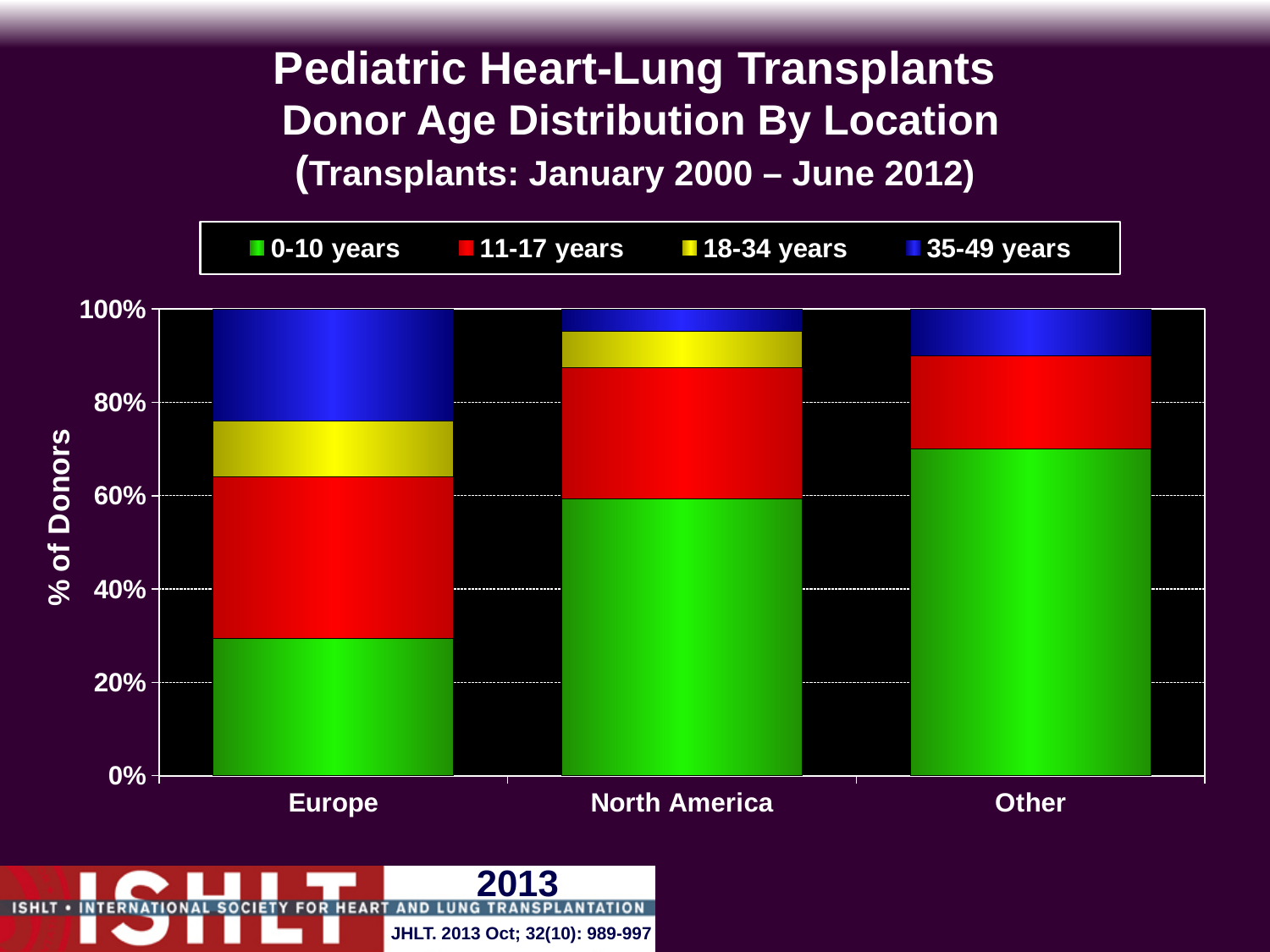
What is the label on the y axis? % of Donors Which location has the largest share of donors aged 35-49 years? Europe Is the share of 0-10 year donors in Europe greater or less than 40%? less Is the share of 0-10 year donors in Other greater or less than 60%? greater How many donor age groups does the legend list? 4 Which location has the smallest share of donors aged 0-10 years? Europe Which location has the largest share of donors aged 0-10 years? Other How many locations are shown on the x axis? 3 What does each stacked bar total? 100% What kind of chart is shown on the slide? stacked bar chart Which has a larger share of 0-10 year donors, Europe or North America? North America Is the share of 0-10 year donors in North America greater or less than 40%? greater